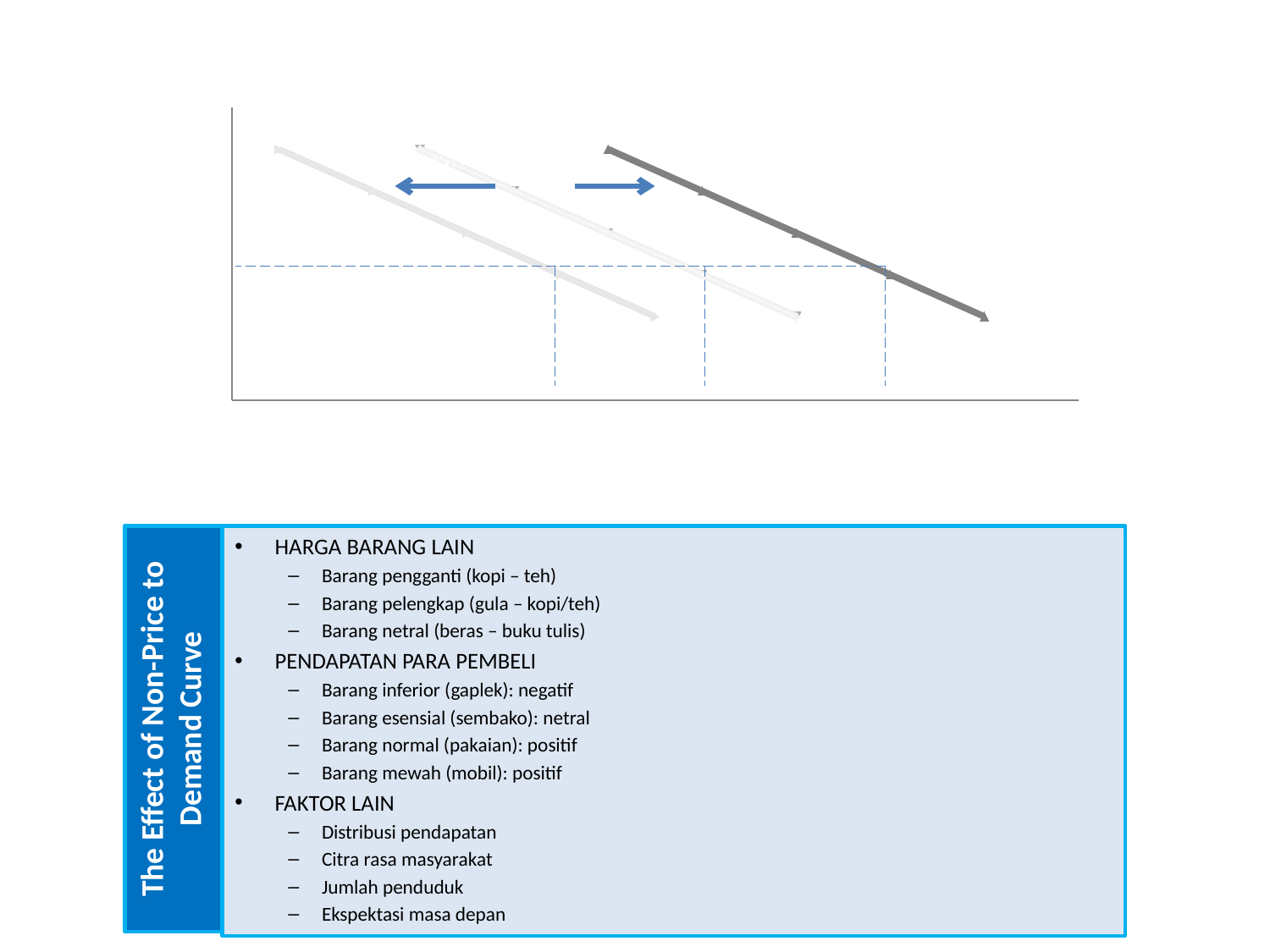
How many sloping lines (curves) are plotted in the chart? 3 Do the plotted lines rise or fall as they move from left to right along the x axis? fall How many vertical dashed lines drop from the curves to the x axis in the chart? 3 Which of the three plotted lines is drawn in the darkest colour: the leftmost, the middle, or the rightmost? the rightmost What kind of chart is shown at the top of the slide? line chart